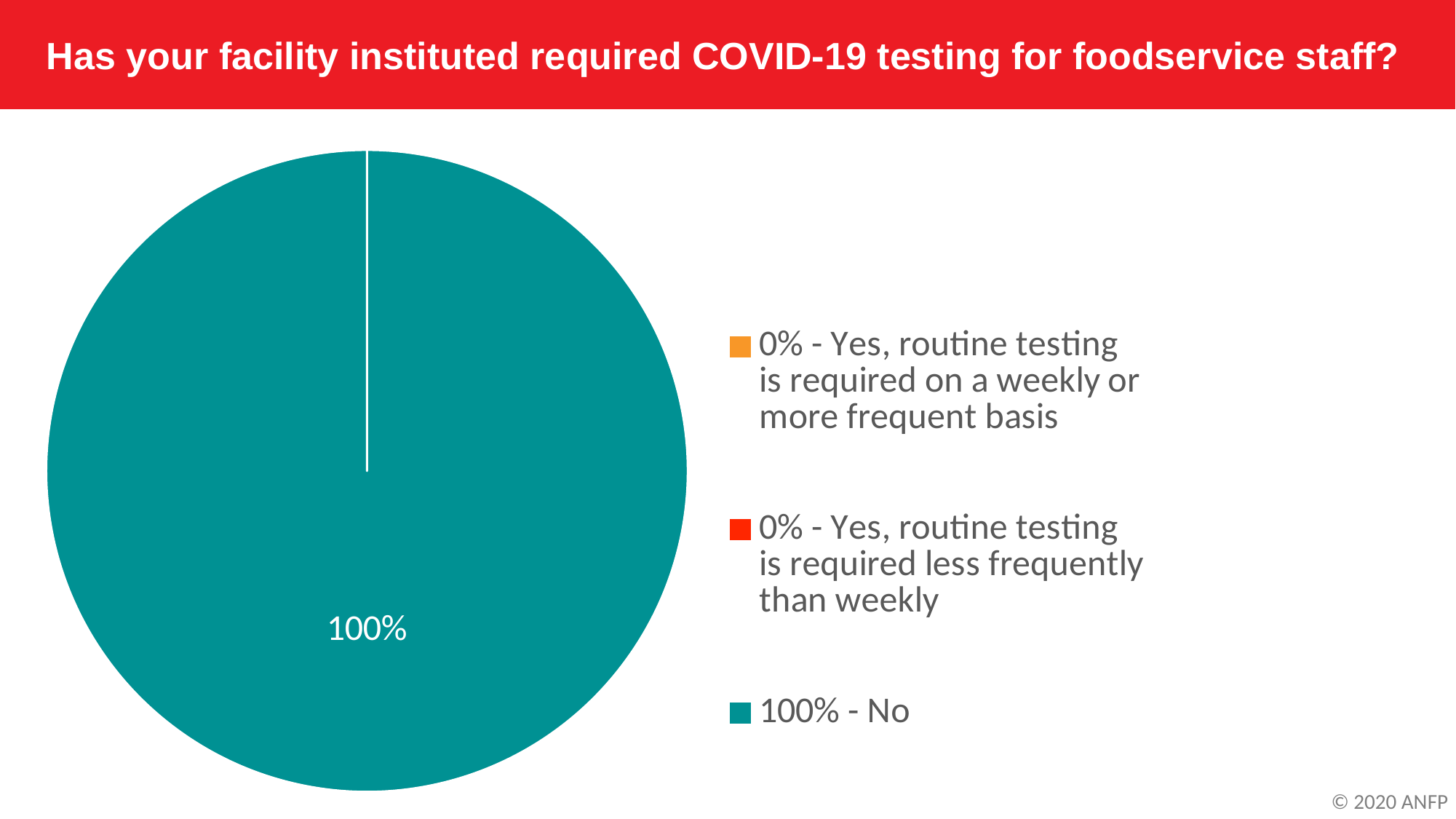
What kind of chart is shown on the slide? pie chart Which is larger: the share for "No" or the share for "Yes, routine testing is required on a weekly or more frequent basis"? No What percentage is shown for "Yes, routine testing is required less frequently than weekly"? 0% Which response category has the largest share of the pie? No What percentage is shown for "Yes, routine testing is required on a weekly or more frequent basis"? 0% What is the total of all the percentages listed in the legend? 100% How many response categories does the legend list? 3 What is the title of the chart on the slide? Has your facility instituted required COVID-19 testing for foodservice staff? What is the difference between the share for "No" and the share for "Yes, routine testing is required less frequently than weekly"? 100% What colour is the slice representing "No"? teal What share of the pie does the "No" response hold? 100%